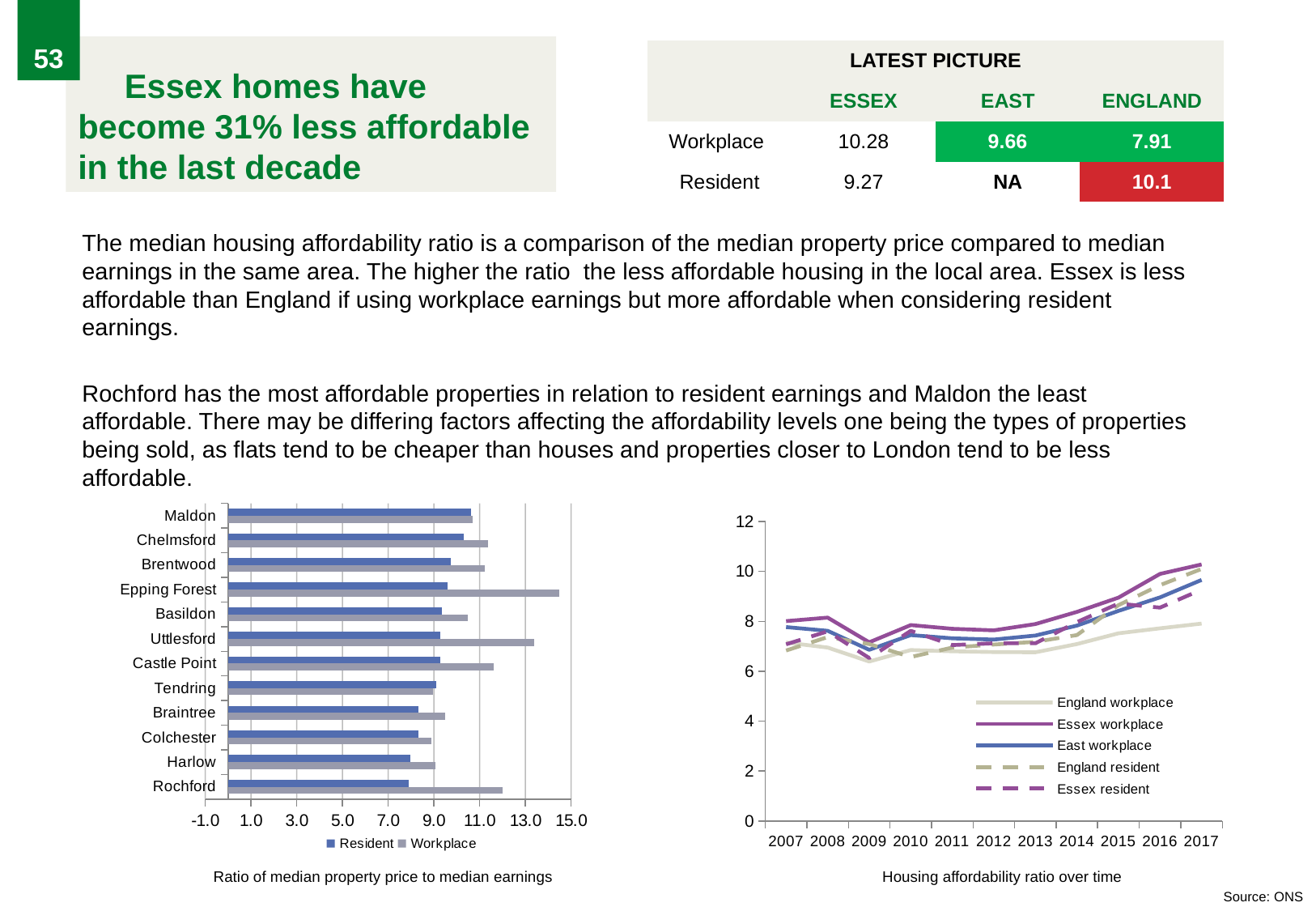
In the 'Housing affordability ratio over time' chart, does the Essex workplace line rise or fall overall from 2007 to 2017? Rise In the 'Housing affordability ratio over time' chart, which series has the highest value in 2017? Essex workplace In the 'Housing affordability ratio over time' chart, how many series does the legend list? 5 What kind of chart is the 'Housing affordability ratio over time' chart on the right? Line chart In the 'Ratio of median property price to median earnings' chart, is the Workplace value for Epping Forest greater or less than 13.0? greater In the 'Housing affordability ratio over time' chart, how many years are shown on the x axis? 11 In the 'Ratio of median property price to median earnings' chart, how many series does the legend list? 2 What kind of chart is the 'Ratio of median property price to median earnings' chart on the left? Bar chart In the 'Ratio of median property price to median earnings' chart, which is larger for Rochford: the Resident value or the Workplace value? Workplace In the 'Ratio of median property price to median earnings' chart, which district has the highest Workplace ratio? Epping Forest In the 'Ratio of median property price to median earnings' chart, how many districts are listed? 12 In the 'Ratio of median property price to median earnings' chart, is the Workplace value for Rochford greater or less than 11.0? greater